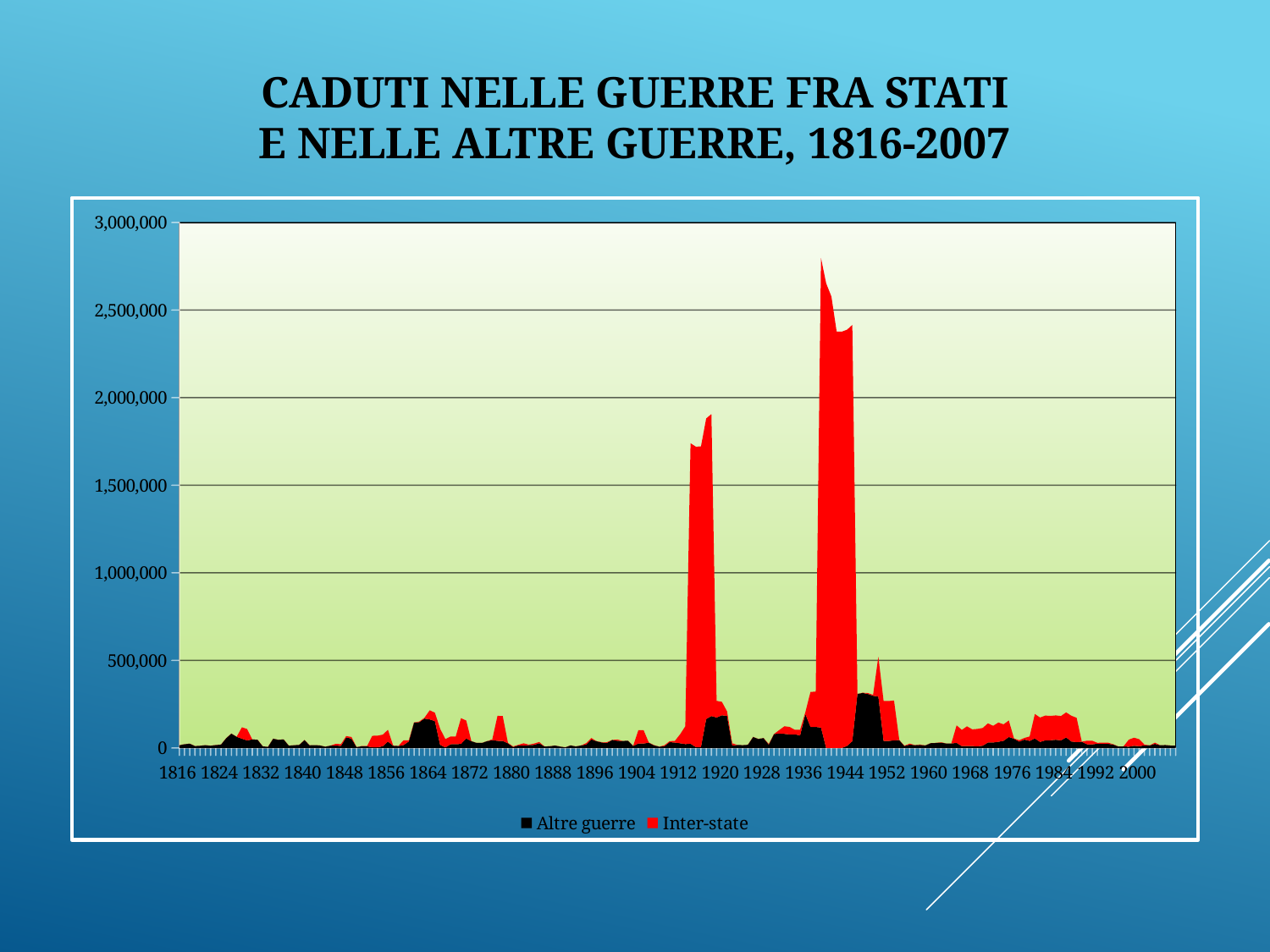
Is the highest peak of the Inter-state series greater or less than 2,500,000? greater Is the peak of the Inter-state series around 1916-1920 greater or less than 1,500,000? greater Which is larger: the Inter-state peak in the 1940s or the Inter-state peak around 1916-1920? The peak in the 1940s How many year labels are shown on the x axis? 24 Is the total value for 1880 greater or less than 500,000? less What colour represents the Inter-state series? Red What kind of chart is shown on the slide? Area chart Which series reaches the highest values on the chart? Inter-state How many series does the legend list? 2 What are the two series named in the legend? Altre guerre and Inter-state